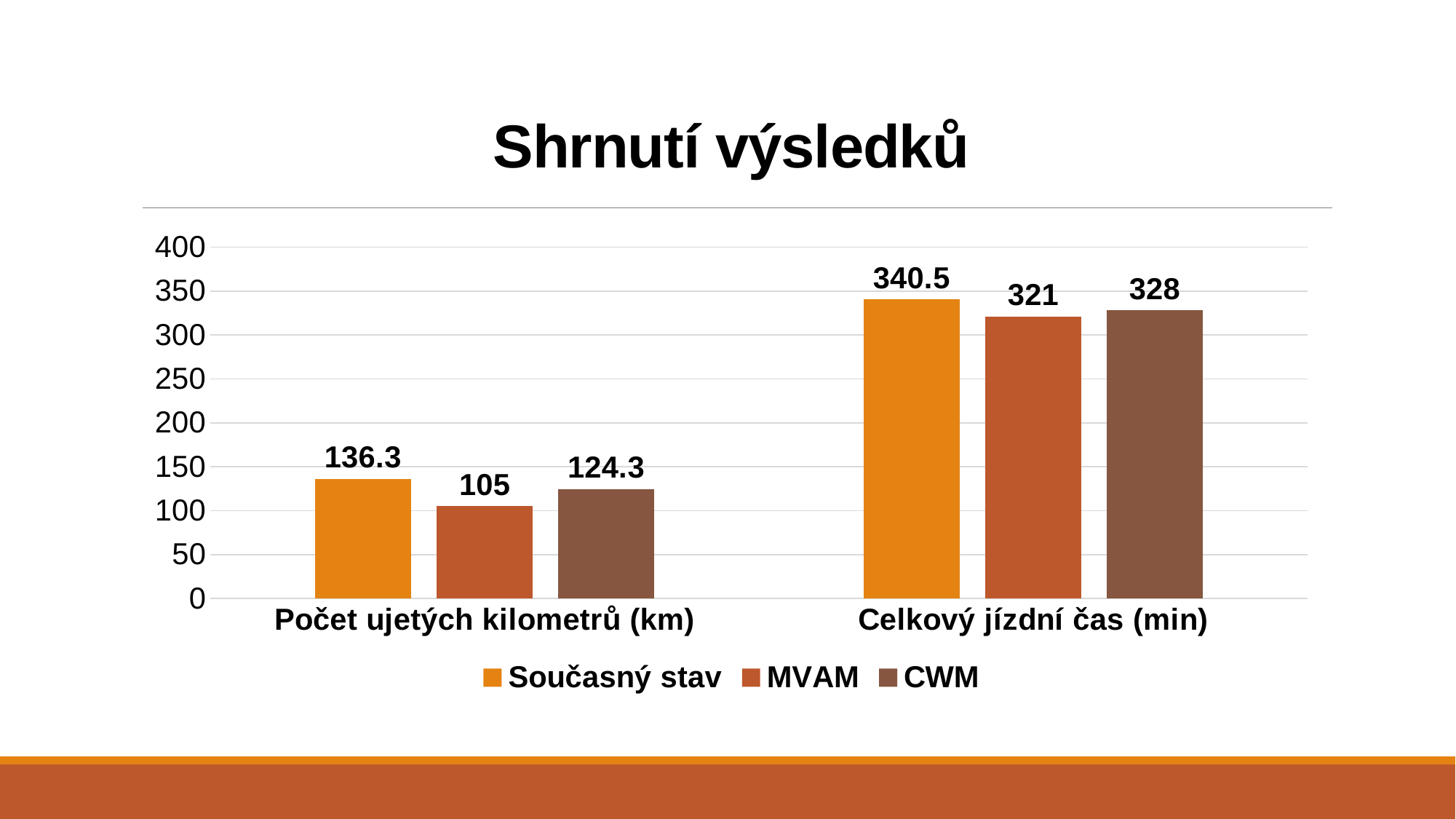
Which is larger in the Celkový jízdní čas (min) category: MVAM or CWM? CWM How many categories are shown on the x axis? 2 Which series has the highest value in the Celkový jízdní čas (min) category? Současný stav What is the value for CWM in the Počet ujetých kilometrů (km) category? 124.3 How many series does the legend list? 3 What kind of chart is shown on the slide? bar chart Is the value for MVAM in the Celkový jízdní čas (min) category greater or less than 300? greater What is the value for MVAM in the Celkový jízdní čas (min) category? 321 What is the difference between Současný stav and MVAM in the Celkový jízdní čas (min) category? 19.5 Which series has the lowest value in the Počet ujetých kilometrů (km) category? MVAM What is the difference between Současný stav and CWM in the Počet ujetých kilometrů (km) category? 12 What is the value for Současný stav in the Počet ujetých kilometrů (km) category? 136.3